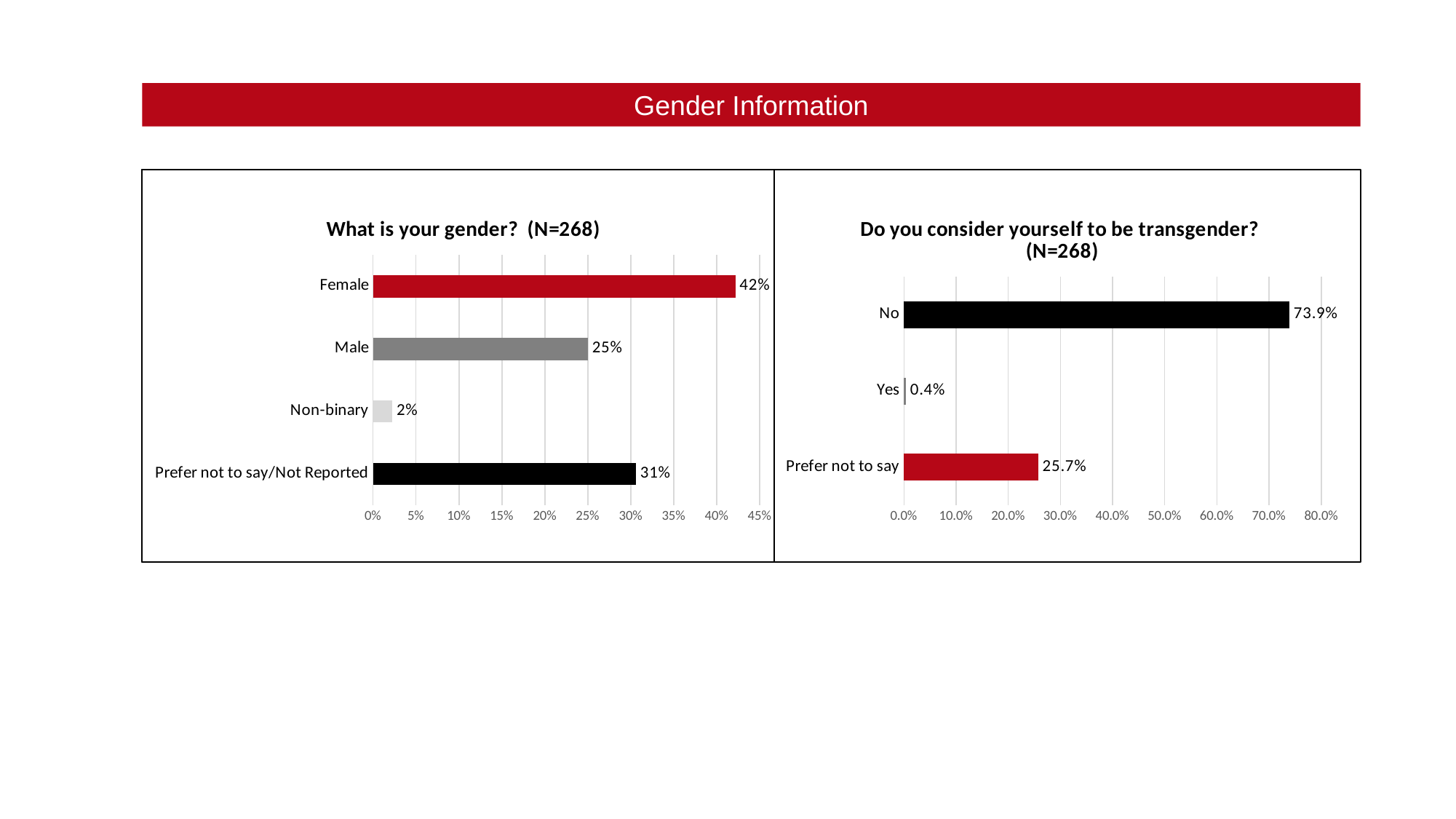
In the 'What is your gender?' chart, what is the difference between the Female and Male values? 17% In the 'Do you consider yourself to be transgender?' chart, what is the value for Yes? 0.4% In the 'What is your gender?' chart, how many categories are shown? 4 In the 'What is your gender?' chart, which category has the highest value? Female In the 'Do you consider yourself to be transgender?' chart, which is larger, Prefer not to say or Yes? Prefer not to say In the 'Do you consider yourself to be transgender?' chart, what is the value for No? 73.9% In the 'What is your gender?' chart, what is the value for Prefer not to say/Not Reported? 31% In the 'What is your gender?' chart, what is the value for Female? 42% In the 'What is your gender?' chart, what colour is the Male bar? Grey In the 'Do you consider yourself to be transgender?' chart, what is the difference between the No and Prefer not to say values? 48.2% In the 'What is your gender?' chart, which category has the lowest value? Non-binary What kind of chart is the 'Do you consider yourself to be transgender?' chart? Bar chart